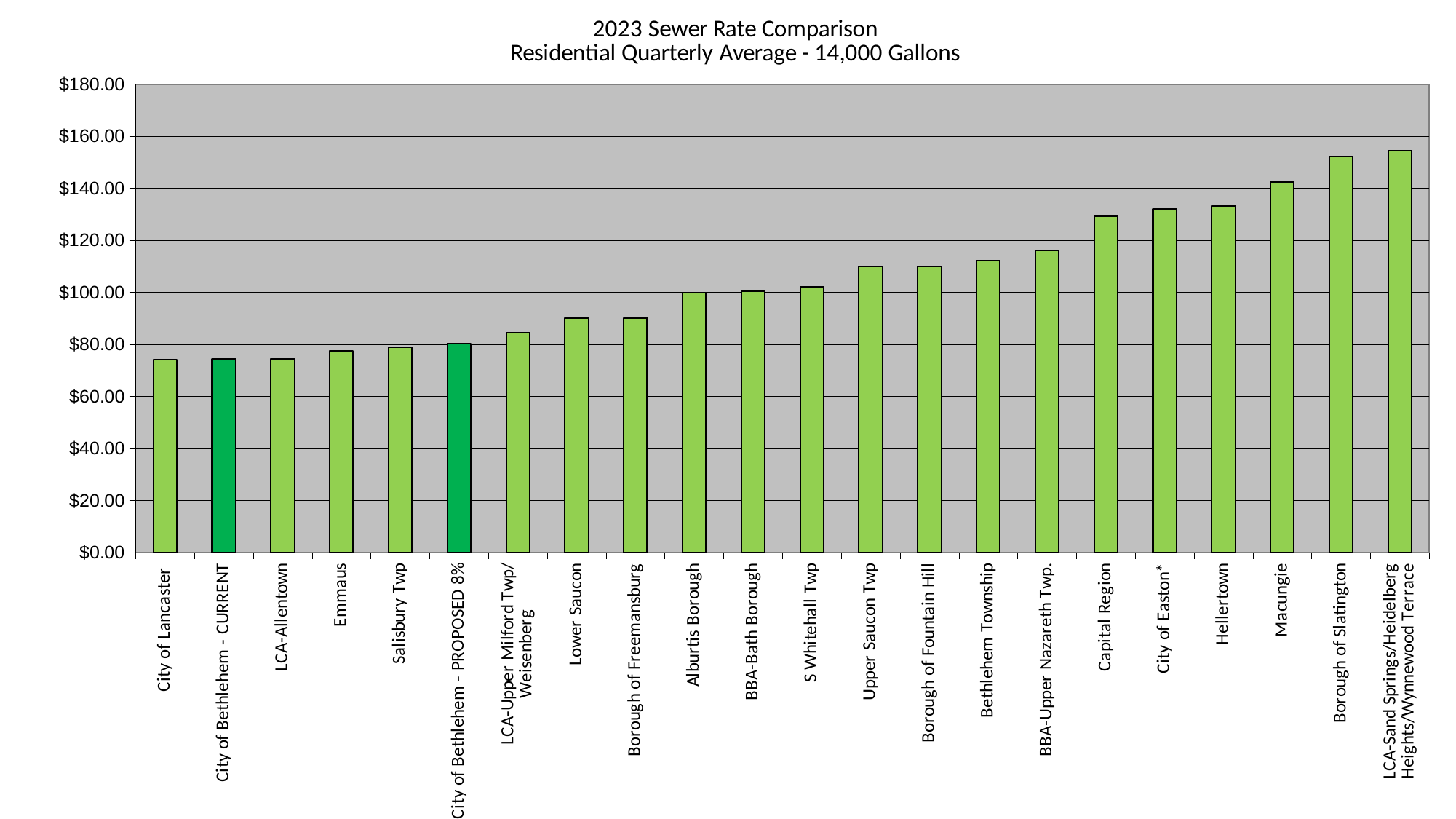
Is the value for Borough of Slatington greater or less than $140.00? greater What is the title of the chart? 2023 Sewer Rate Comparison Residential Quarterly Average - 14,000 Gallons Which has the larger value, City of Bethlehem - PROPOSED 8% or City of Bethlehem - CURRENT? City of Bethlehem - PROPOSED 8% Is the value for Emmaus greater or less than $80.00? less How many municipalities or categories are plotted in the chart? 22 Is the value for Lower Saucon greater or less than $80.00? greater Which has the larger value, Bethlehem Township or Lower Saucon? Bethlehem Township What kind of chart is shown on the slide? bar chart Do the bar values generally rise or fall from left to right across the chart? rise Which has the larger value, Macungie or Hellertown? Macungie